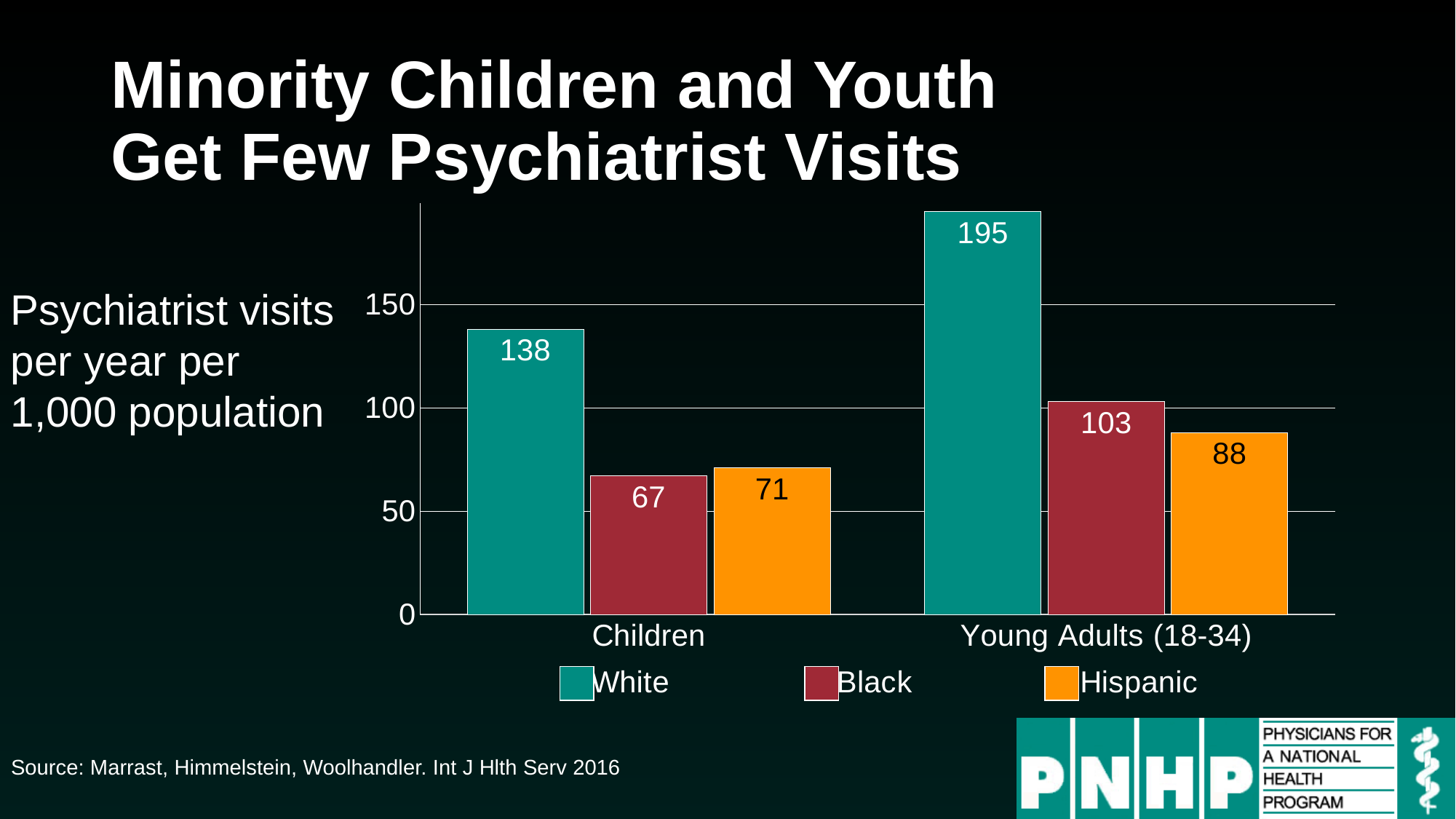
Is the value for Black in the Young Adults (18-34) category greater or less than 100? greater What is the difference between the White and Black values for Young Adults (18-34)? 92 Which is larger: the Black value for Children or the Hispanic value for Children? Hispanic How many categories are shown on the x axis? 2 What is the value for White in the Children category? 138 Which series has the lowest value in the Children category? Black What is the difference between the Hispanic values for Young Adults (18-34) and Children? 17 What is the value for Black in the Children category? 67 What kind of chart is shown on the slide? Bar chart Which series has the highest value in the Young Adults (18-34) category? White What is the value for Hispanic in the Young Adults (18-34) category? 88 How many series does the legend list? 3